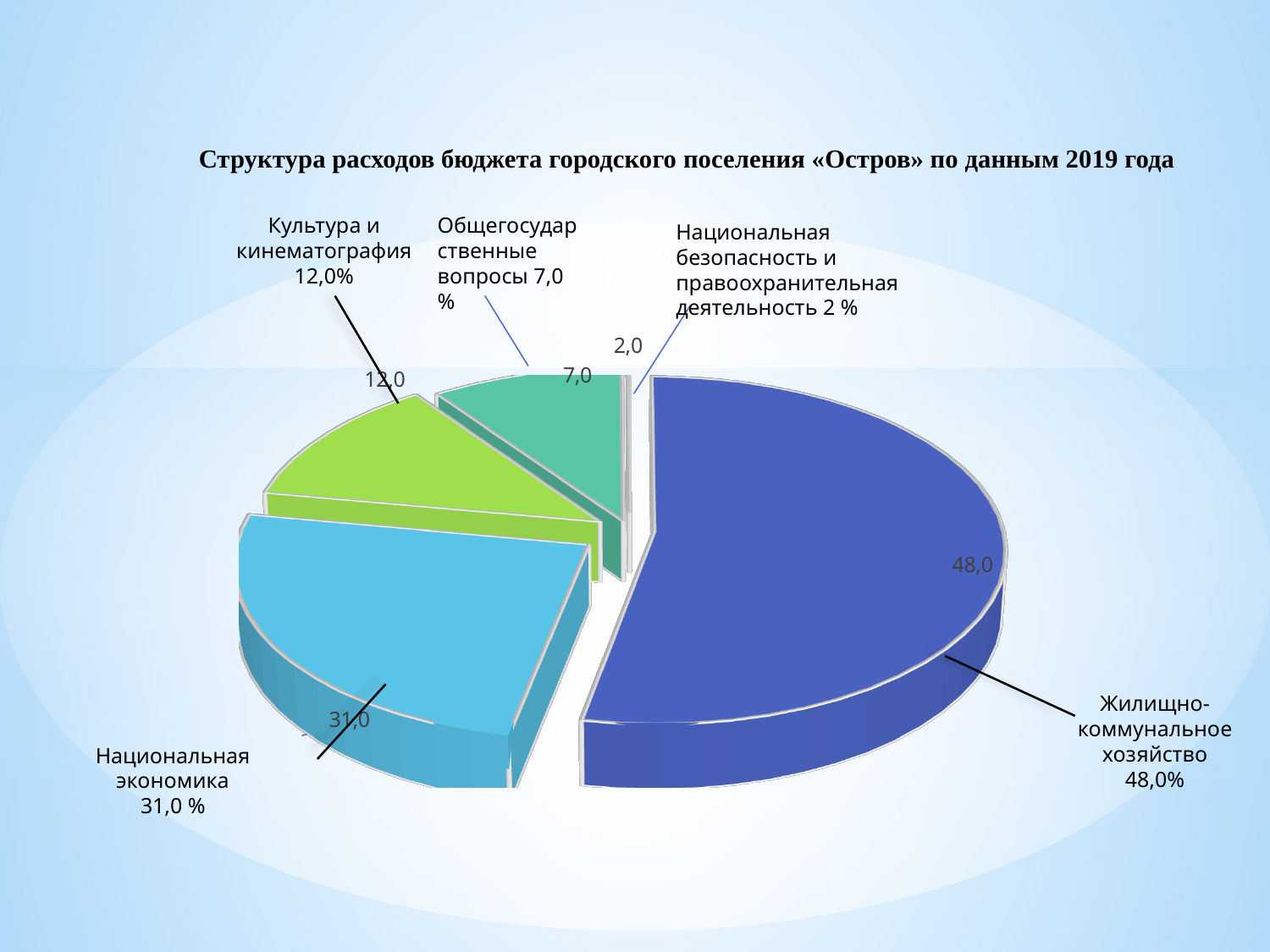
Какое значение указано для сектора «Общегосударственные вопросы»? 7,0 Какая категория расходов имеет наименьшую долю? Национальная безопасность и правоохранительная деятельность На сколько доля «Жилищно-коммунальное хозяйство» больше доли «Национальная экономика»? 17,0 Какое значение указано для сектора «Культура и кинематография»? 12,0 Как называется диаграмма на слайде? Структура расходов бюджета городского поселения «Остров» по данным 2019 года Что больше: доля «Культура и кинематография» или доля «Общегосударственные вопросы»? Культура и кинематография Какая категория расходов имеет наибольшую долю? Жилищно-коммунальное хозяйство Сколько секторов на диаграмме? 5 Какое значение указано для сектора «Жилищно-коммунальное хозяйство»? 48,0 Какое значение указано для сектора «Национальная экономика»? 31,0 Какое значение указано для сектора «Национальная безопасность и правоохранительная деятельность»? 2,0 Какой тип диаграммы показан на слайде? Круговая диаграмма